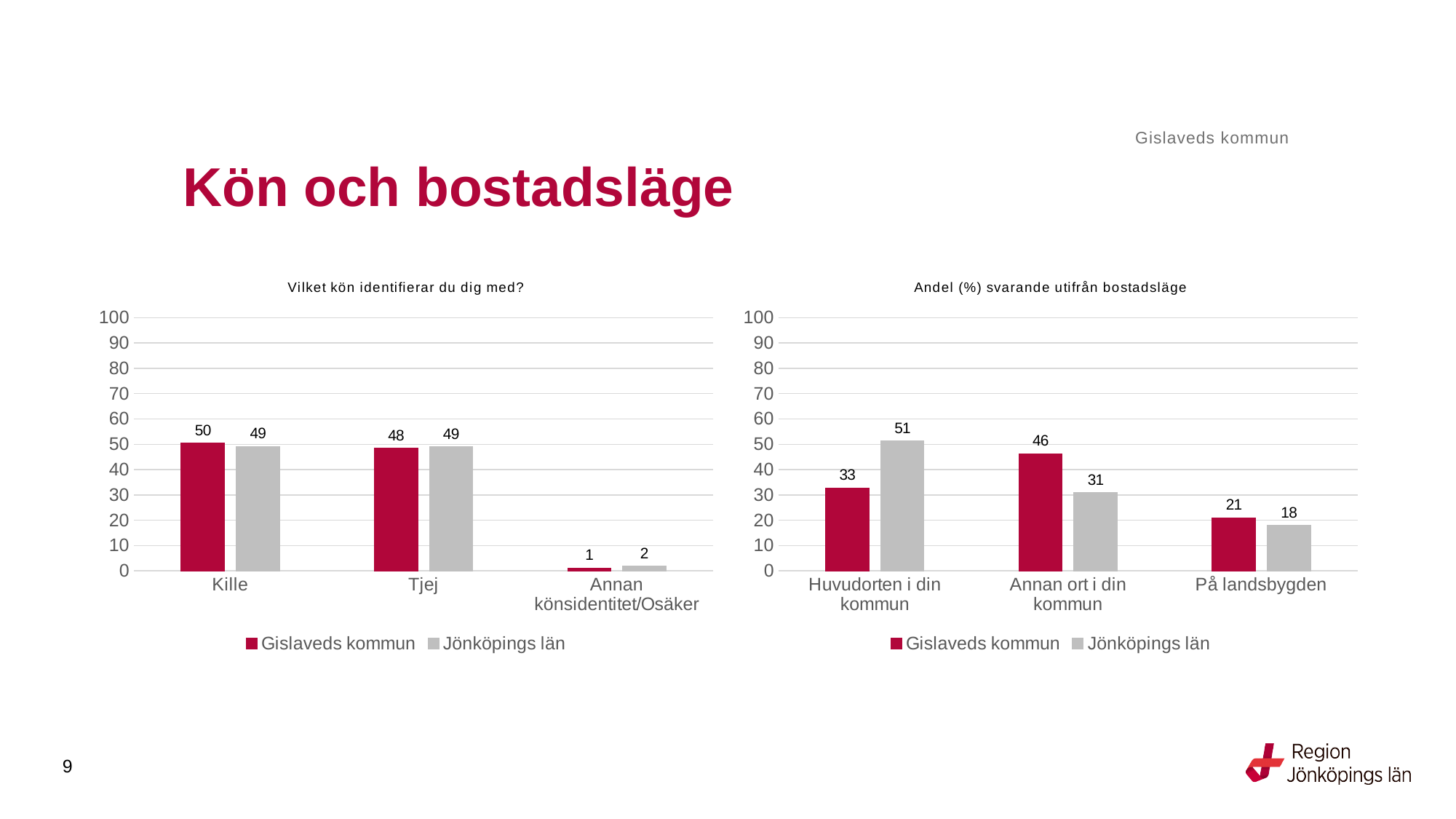
In the chart 'Vilket kön identifierar du dig med?', which category has the lowest value for Gislaveds kommun? Annan könsidentitet/Osäker How many series does the legend of the chart 'Andel (%) svarande utifrån bostadsläge' list? 2 In the chart 'Vilket kön identifierar du dig med?', what is the value for Gislaveds kommun for Kille? 50 In the chart 'Vilket kön identifierar du dig med?', what is the difference between the Gislaveds kommun and Jönköpings län values for Tjej? 1 In the chart 'Andel (%) svarande utifrån bostadsläge', which is larger for Huvudorten i din kommun: Gislaveds kommun or Jönköpings län? Jönköpings län In the chart 'Vilket kön identifierar du dig med?', how many categories are shown on the x axis? 3 In the chart 'Vilket kön identifierar du dig med?', what is the value for Jönköpings län for Tjej? 49 In the chart 'Andel (%) svarande utifrån bostadsläge', what is the difference between the Gislaveds kommun and Jönköpings län values for Annan ort i din kommun? 15 In the chart 'Andel (%) svarande utifrån bostadsläge', what is the value for Gislaveds kommun for Annan ort i din kommun? 46 In the chart 'Andel (%) svarande utifrån bostadsläge', which category has the highest value for Jönköpings län? Huvudorten i din kommun What kind of chart is 'Vilket kön identifierar du dig med?'? Bar chart In the chart 'Andel (%) svarande utifrån bostadsläge', what is the value for Jönköpings län for Huvudorten i din kommun? 51